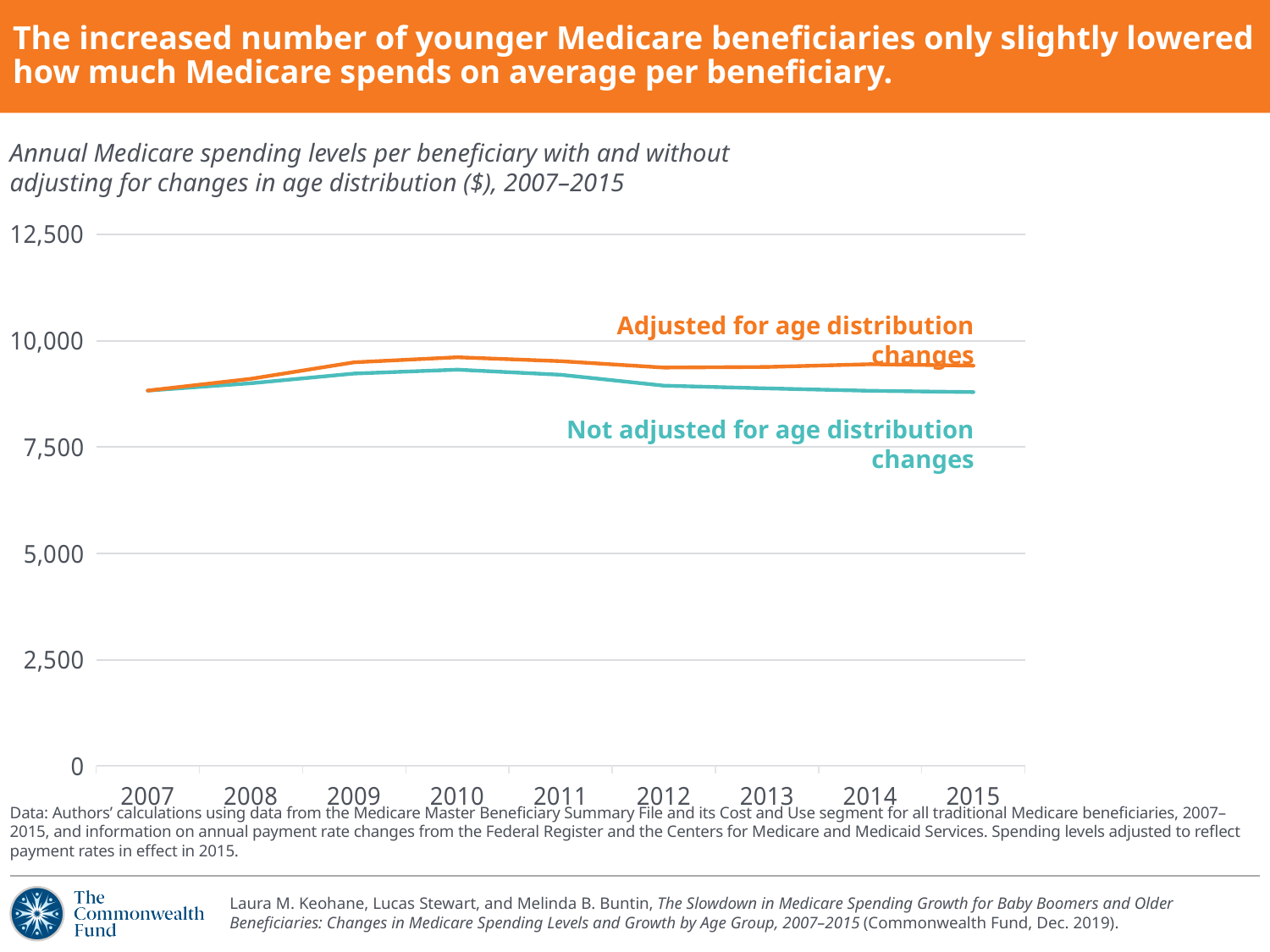
What kind of chart is shown on the slide? Line chart Is the value for the 'Adjusted for age distribution changes' line in 2007 greater or less than 7,500? greater What is the highest value labelled on the y axis? 12,500 Does the 'Adjusted for age distribution changes' line rise or fall from 2007 to 2010? Rise What colour is the 'Not adjusted for age distribution changes' line? Teal How many series are plotted on the chart? 2 How many years are shown along the x axis? 9 Which year is the first on the x axis? 2007 In 2015, which line is higher: 'Adjusted for age distribution changes' or 'Not adjusted for age distribution changes'? Adjusted for age distribution changes Does the 'Not adjusted for age distribution changes' line rise or fall from 2010 to 2015? Fall Is the value for the 'Adjusted for age distribution changes' line in 2010 greater or less than 10,000? less Is the value for the 'Not adjusted for age distribution changes' line in 2015 greater or less than 7,500? greater